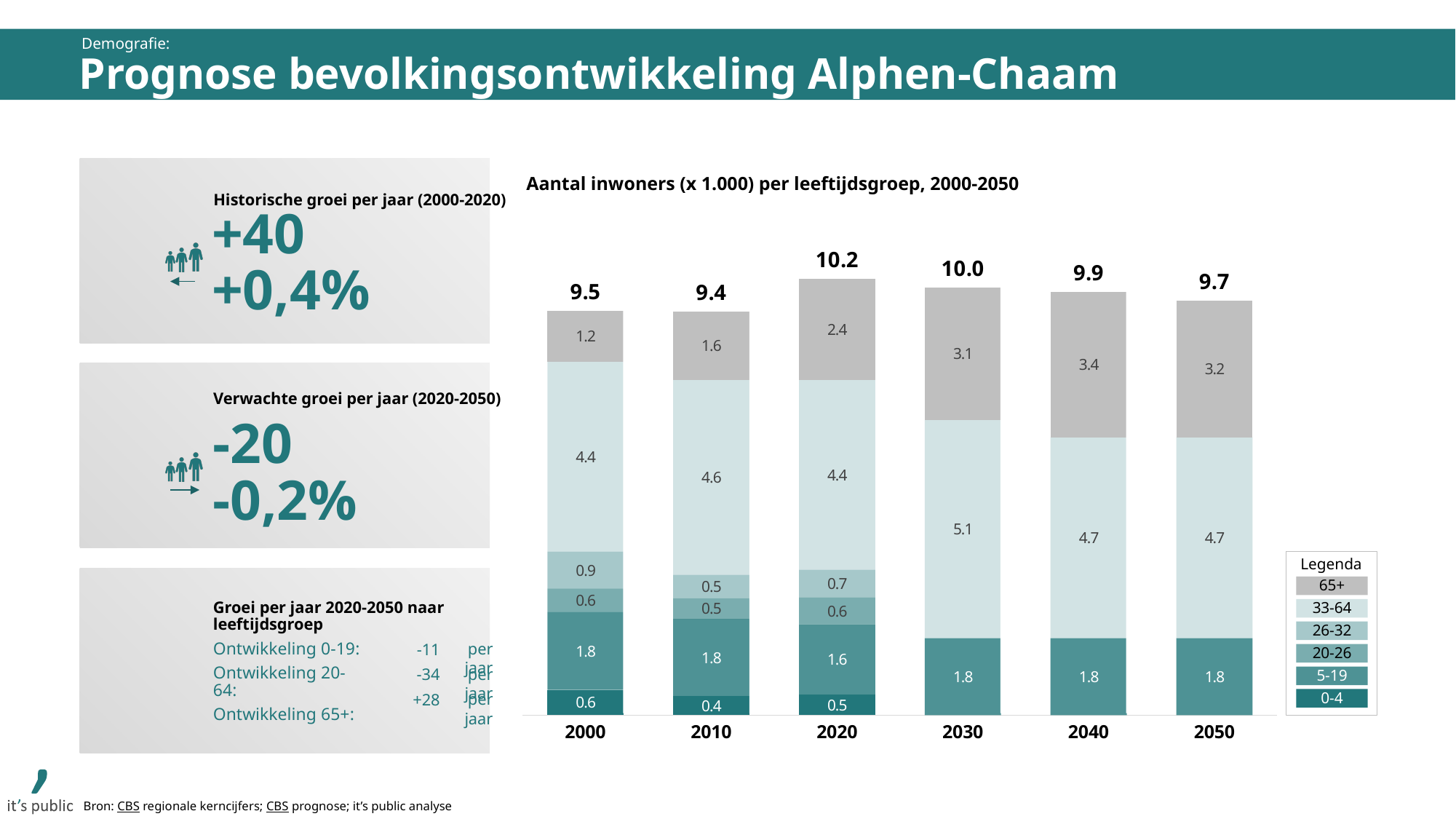
How many years are shown on the x axis? 6 What is the difference between the 65+ segment in 2050 and in 2000? 2.0 What is the value of the 33-64 segment in 2030? 5.1 Which year has the lowest total number of inhabitants? 2010 Is the 33-64 segment larger in 2010 or in 2020? 2010 Which year has the highest total number of inhabitants? 2020 What is the total number of inhabitants (x 1.000) shown for 2020? 10.2 How many age groups does the legend list? 6 What is the title of the chart? Aantal inwoners (x 1.000) per leeftijdsgroep, 2000-2050 What is the value of the 65+ segment in 2040? 3.4 What kind of chart is shown on the slide? stacked bar chart What is the value of the 0-4 segment in 2000? 0.6